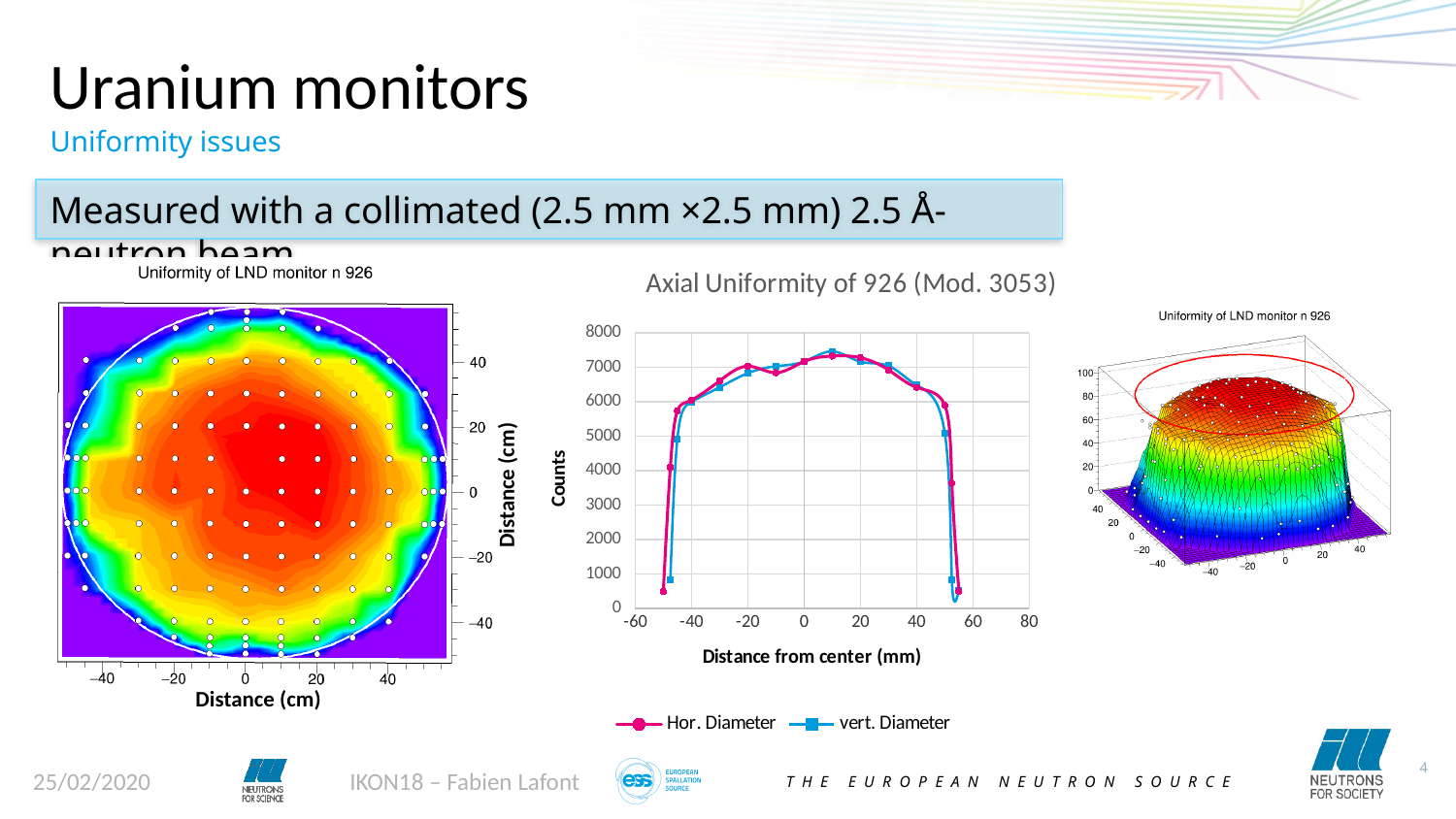
In the 'Axial Uniformity of 926 (Mod. 3053)' chart, is the Hor. Diameter value at -50 mm greater or less than 3000? less In the 'Axial Uniformity of 926 (Mod. 3053)' chart, what is the label of the x axis? Distance from center (mm) In the 'Axial Uniformity of 926 (Mod. 3053)' chart, at 50 mm, which series has the larger count: Hor. Diameter or vert. Diameter? Hor. Diameter In the 'Axial Uniformity of 926 (Mod. 3053)' chart, is the vert. Diameter value at -50 mm greater or less than 2000? less In the 'Axial Uniformity of 926 (Mod. 3053)' chart, is the vert. Diameter value at 40 mm greater or less than 5000? greater In the 'Axial Uniformity of 926 (Mod. 3053)' chart, do the counts rise or fall as the distance from center goes from -50 mm to 0 mm? rise In the 'Axial Uniformity of 926 (Mod. 3053)' chart, what are the two series named in the legend? Hor. Diameter and vert. Diameter In the 'Axial Uniformity of 926 (Mod. 3053)' chart, do the counts rise or fall as the distance from center goes from 10 mm to 50 mm? fall What type of chart is the middle chart titled 'Axial Uniformity of 926 (Mod. 3053)'? line chart In the 'Axial Uniformity of 926 (Mod. 3053)' chart, how many series does the legend list? 2